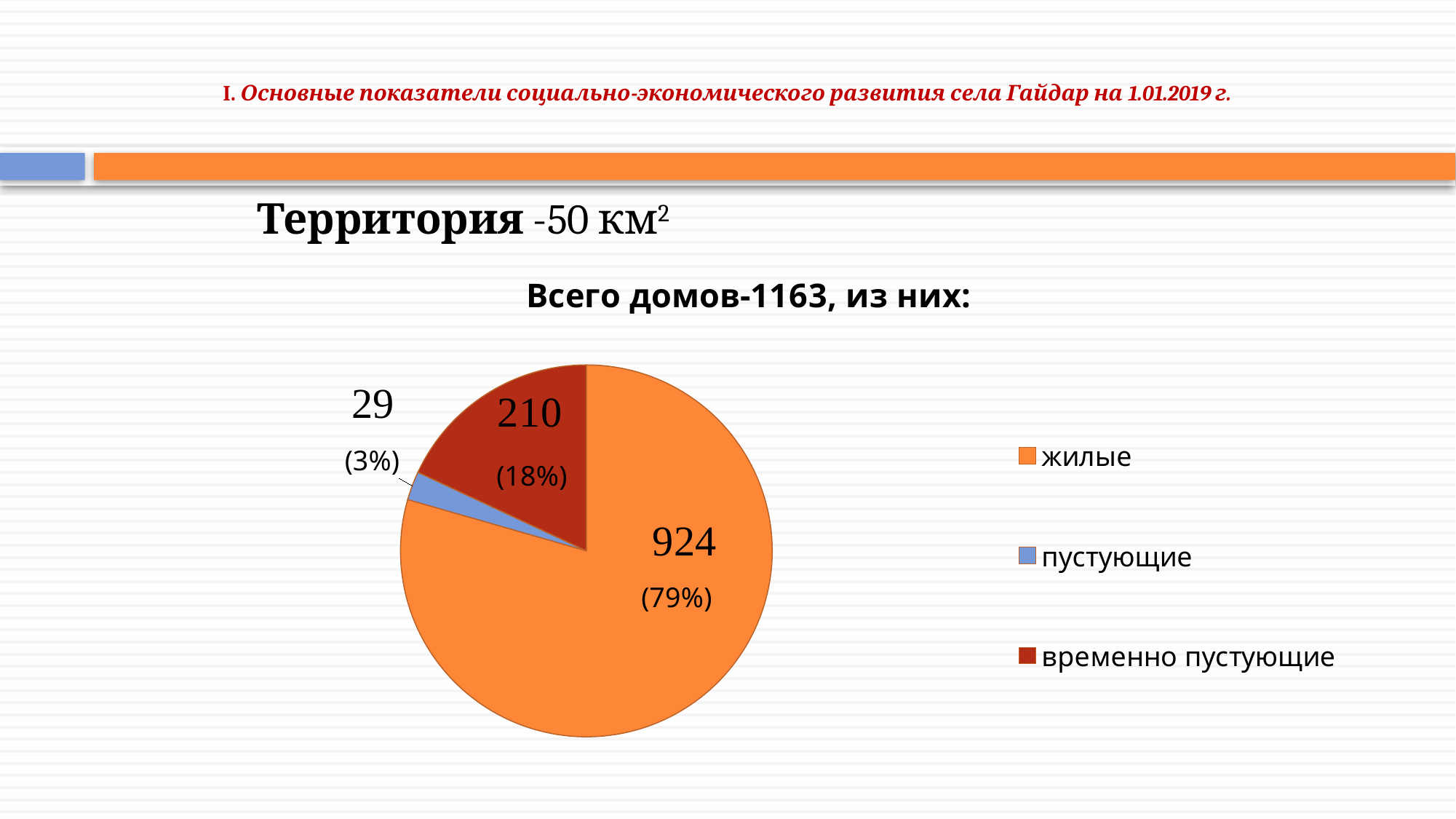
What is the title of the chart? Всего домов-1163, из них: What is the value for временно пустующие? 210 How many categories does the pie chart have? 3 What share of the pie does временно пустующие take? 18% What share of the pie does жилые take? 79% What is the value for жилые? 924 What is the difference between the values for жилые and временно пустующие? 714 Which category has the largest slice? жилые What kind of chart is shown on the slide? pie chart Which category has the smallest slice? пустующие What is the value for пустующие? 29 What share of the pie does пустующие take? 3%